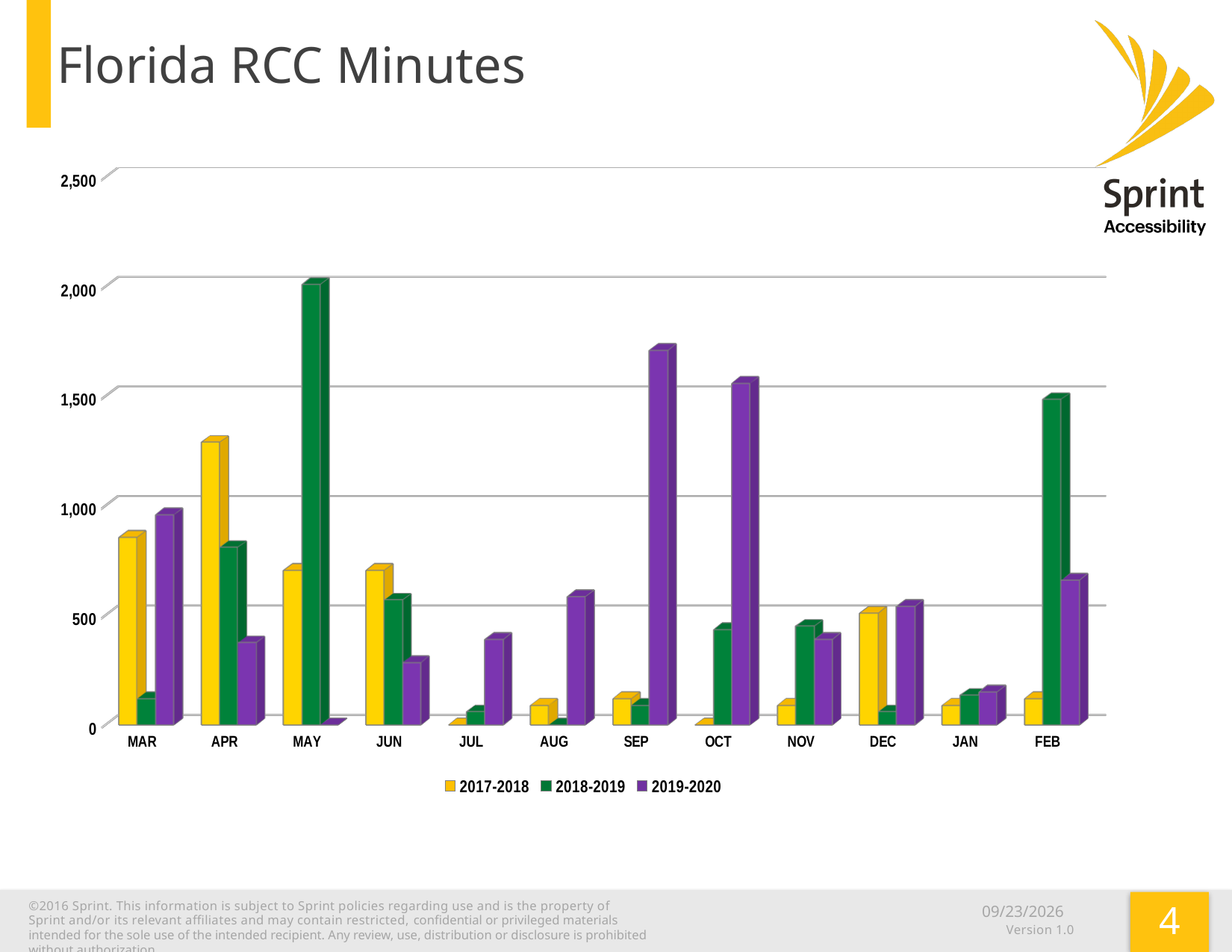
In which month is the 2019-2020 value lowest? MAY Is the 2018-2019 value for MAY greater or less than 1,500? greater In which month is the 2019-2020 value highest? SEP In which month is the 2017-2018 value highest? APR Is the 2017-2018 value for APR greater or less than 1,000? greater What kind of chart is shown on the slide? Bar chart How many months are shown along the x axis? 12 How many series does the legend list? 3 In OCT, which series has the larger value: 2018-2019 or 2019-2020? 2019-2020 In APR, which series has the larger value: 2017-2018 or 2018-2019? 2017-2018 In which month is the 2018-2019 value highest? MAY What colour represents the 2019-2020 series in the legend? Purple